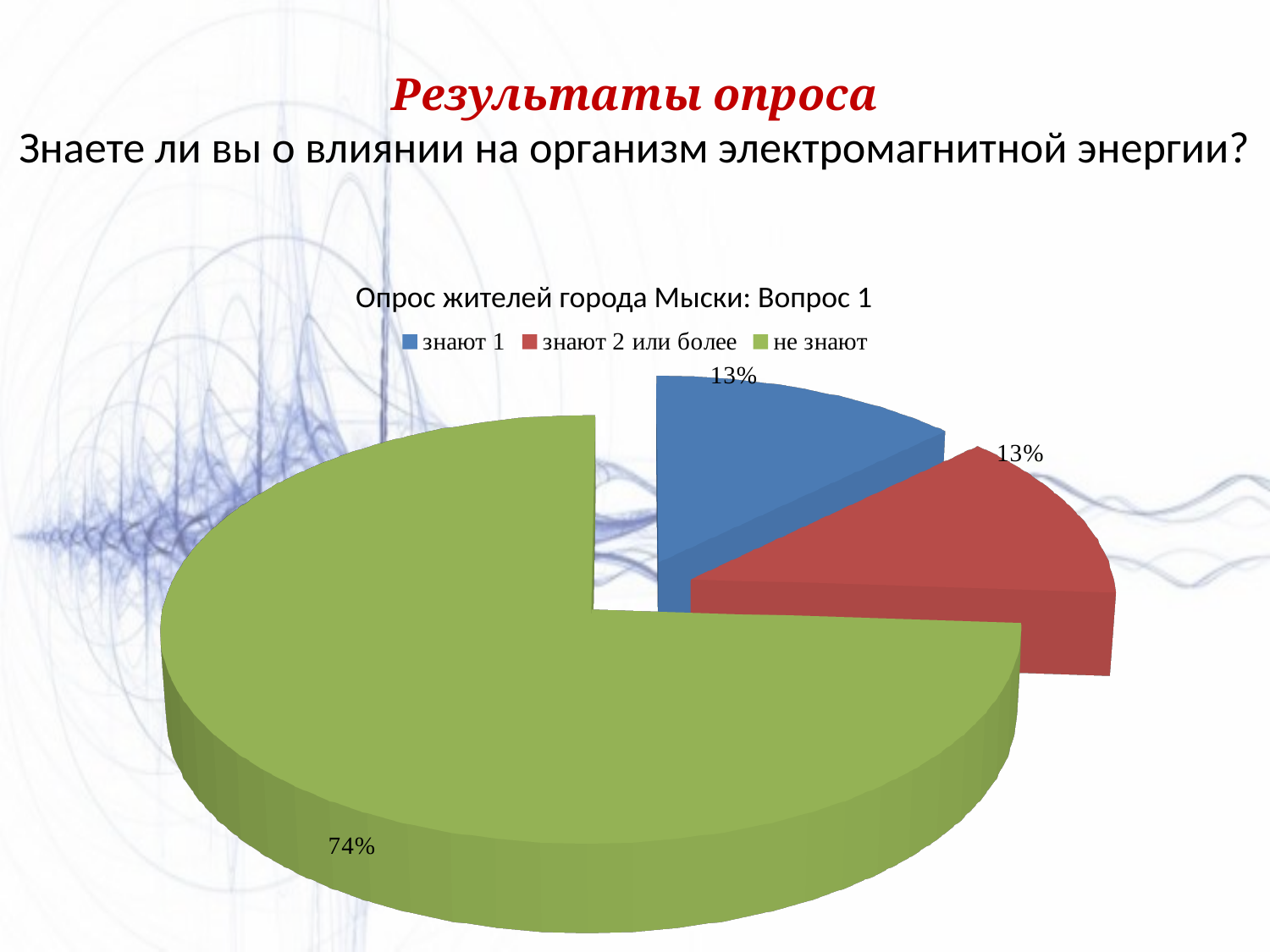
Which category has the largest slice of the pie? не знают What type of chart is shown on the slide? pie chart What is the title of the chart? Опрос жителей города Мыски: Вопрос 1 Which is larger: the share for 'не знают' or the share for 'знают 2 или более'? не знают What share of the pie is labelled for 'не знают'? 74% How many categories does the legend list? 3 Which colour represents 'не знают' in the chart? green What share of the pie is labelled for 'знают 2 или более'? 13% What share of the pie is labelled for 'знают 1'? 13% What is the difference between the share for 'не знают' and the share for 'знают 1'? 61% How many slices does the pie chart have? 3